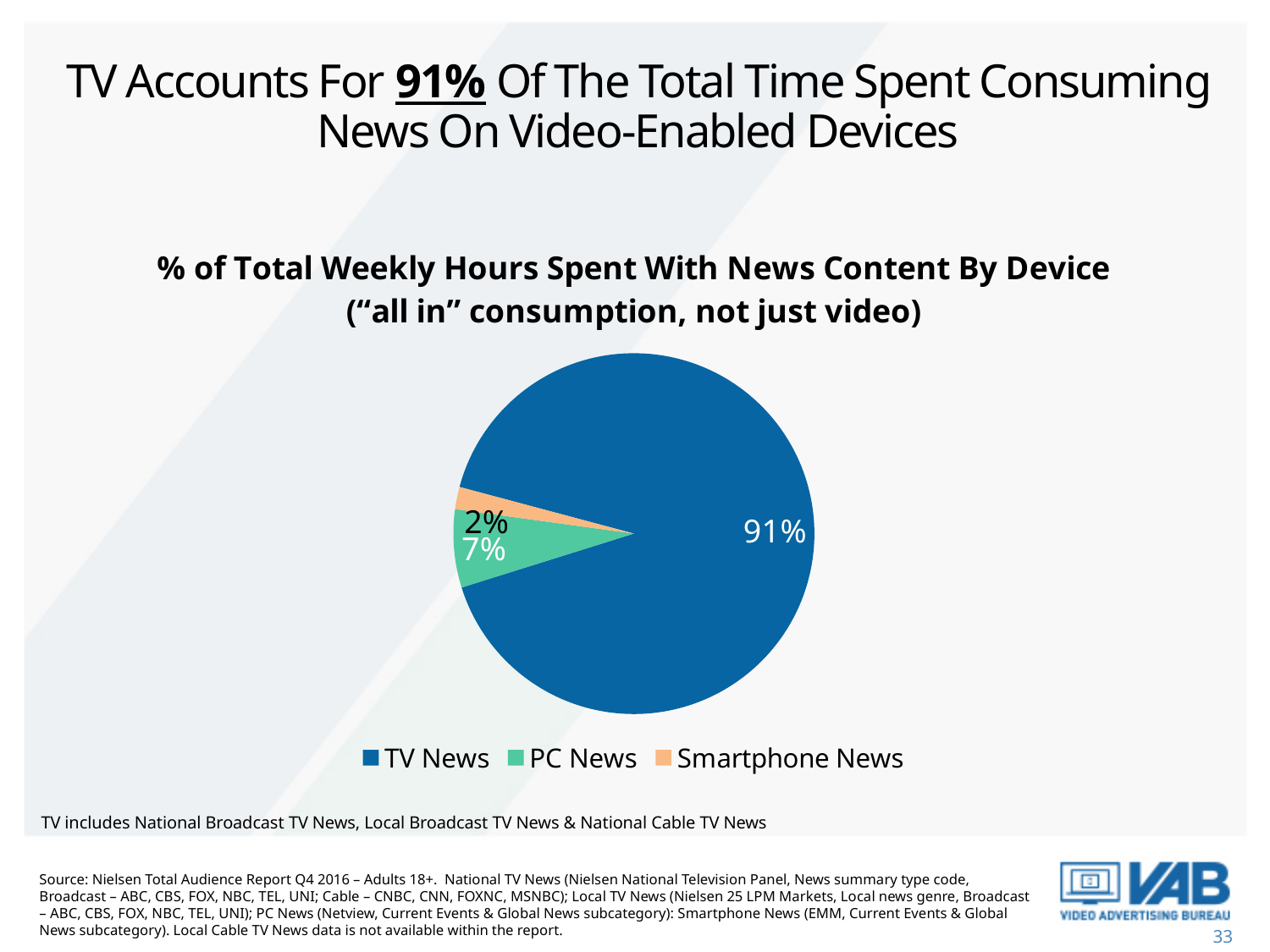
How many slices does the pie chart have? 3 What share of total weekly hours spent with news content is attributed to TV News? 91% How many percentage points larger is the PC News share than the Smartphone News share? 5 percentage points What share of total weekly hours spent with news content is attributed to PC News? 7% What is the title of the pie chart? % of Total Weekly Hours Spent With News Content By Device ("all in" consumption, not just video) What type of chart is shown on the slide? Pie chart How many percentage points larger is the TV News share than the PC News share? 84 percentage points How many entries does the legend list? 3 Which device accounts for the smallest share of weekly hours spent with news content? Smartphone News What share of total weekly hours spent with news content is attributed to Smartphone News? 2% Which device accounts for the largest share of weekly hours spent with news content? TV News Which has a larger share of weekly news hours, PC News or Smartphone News? PC News